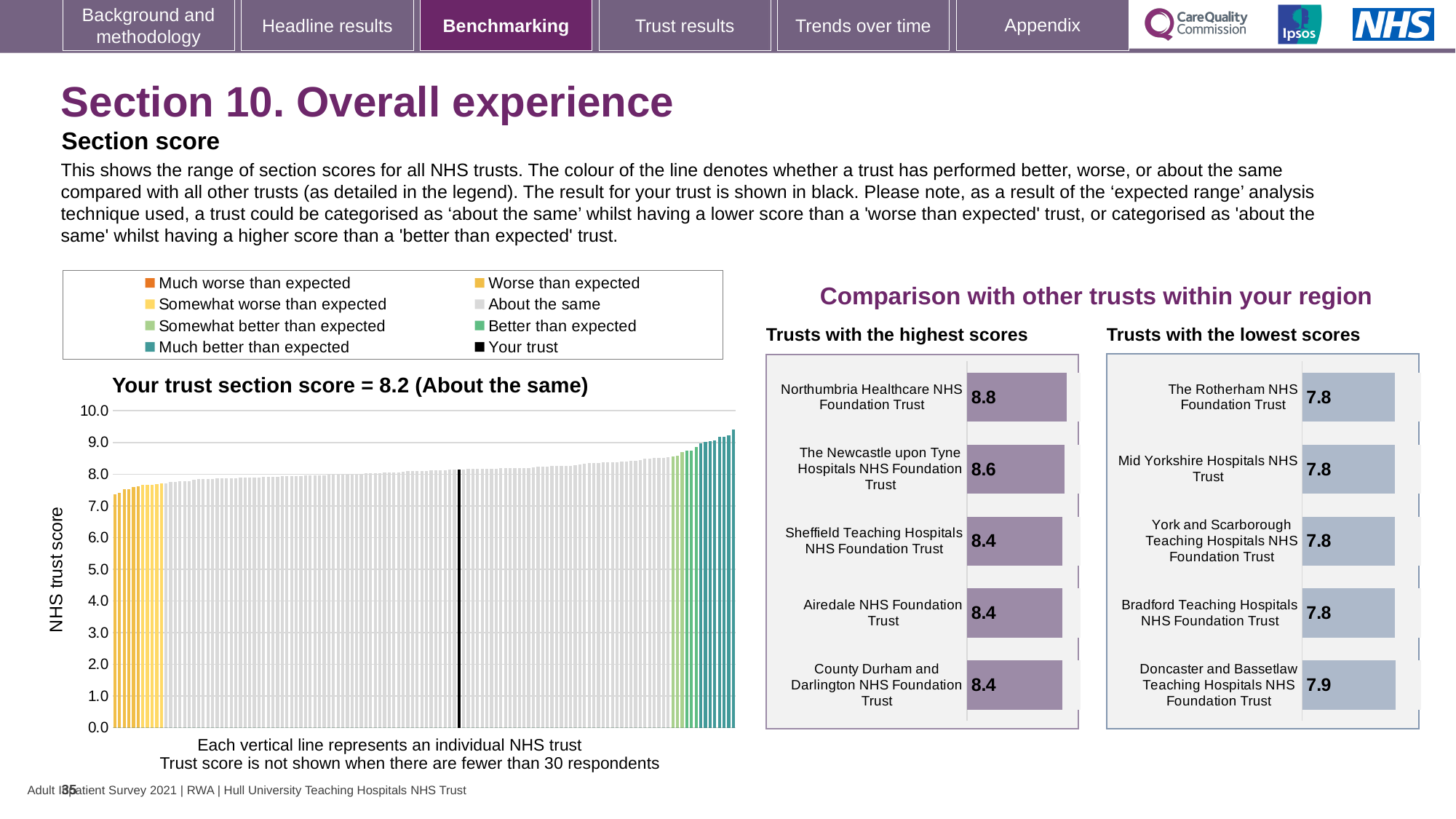
On the 'Your trust section score' chart, what is the section score for your trust? 8.2 On the 'Your trust section score' chart, is the value of the highest bar greater or less than 9.0? greater On the 'Trusts with the lowest scores' chart, what is the score for Doncaster and Bassetlaw Teaching Hospitals NHS Foundation Trust? 7.9 On the 'Your trust section score' chart, what category is your trust placed in? About the same On the 'Trusts with the lowest scores' chart, which is larger: the score for The Rotherham NHS Foundation Trust or the score for Doncaster and Bassetlaw Teaching Hospitals NHS Foundation Trust? Doncaster and Bassetlaw Teaching Hospitals NHS Foundation Trust What kind of chart is the 'Your trust section score' chart? bar chart How many trusts are shown on the 'Trusts with the lowest scores' chart? 5 On the 'Trusts with the highest scores' chart, what is the score for Northumbria Healthcare NHS Foundation Trust? 8.8 How many entries does the legend above the 'Your trust section score' chart list? 8 On the 'Your trust section score' chart, do the bars rise or fall from left to right? rise On the 'Trusts with the highest scores' chart, which trust has the highest score? Northumbria Healthcare NHS Foundation Trust On the 'Trusts with the highest scores' chart, what is the difference between the scores of Northumbria Healthcare NHS Foundation Trust and The Newcastle upon Tyne Hospitals NHS Foundation Trust? 0.2